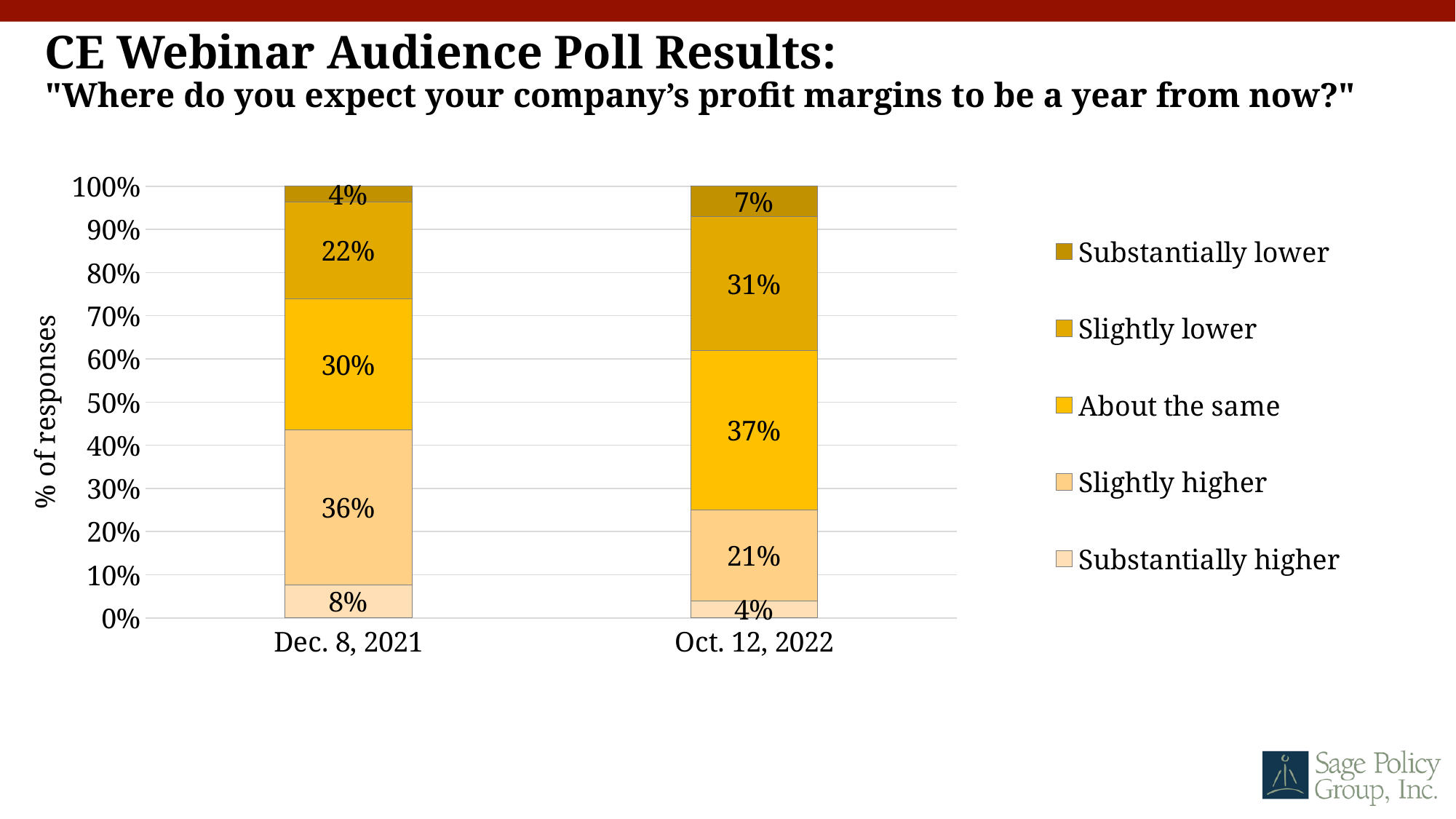
What is the label of the y axis? % of responses Which date had a larger "Slightly higher" share, Dec. 8, 2021 or Oct. 12, 2022? Dec. 8, 2021 What percentage of responses were "Substantially lower" on Oct. 12, 2022? 7% What kind of chart is shown on the slide? Stacked bar chart What percentage of responses were "About the same" on Oct. 12, 2022? 37% What percentage of responses were "Substantially higher" on Dec. 8, 2021? 8% How many dates (bars) are shown on the x axis? 2 What percentage of responses were "Slightly higher" on Dec. 8, 2021? 36% How many response categories does the legend list? 5 By how many percentage points did the "Slightly lower" share change from Dec. 8, 2021 to Oct. 12, 2022? 9 percentage points Which response category had the largest share on Oct. 12, 2022? About the same Which response category had the smallest share on Dec. 8, 2021? Substantially lower